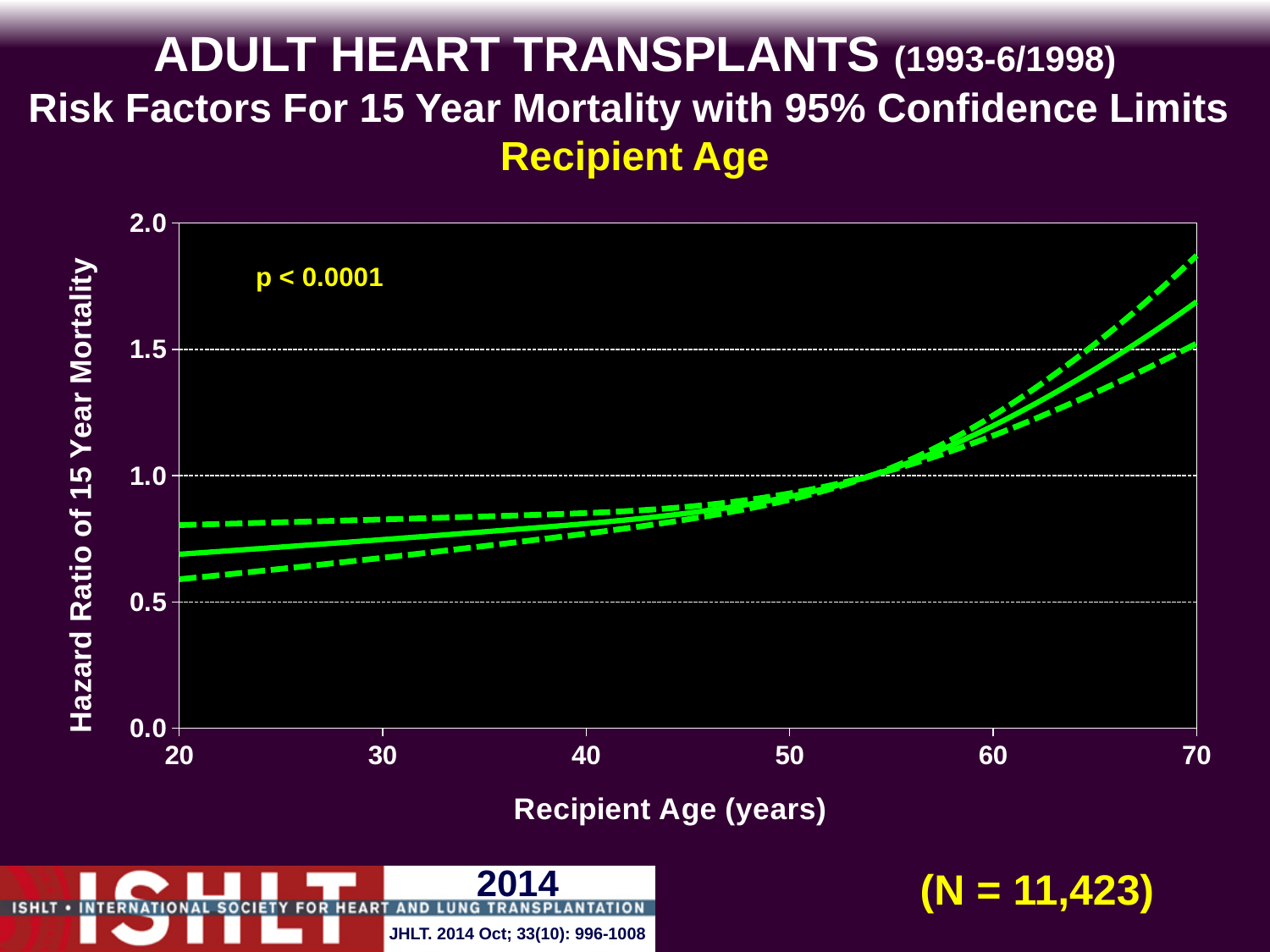
What kind of chart is shown on the slide? line chart Does the hazard ratio of 15 year mortality rise or fall as recipient age increases from 20 to 70 years? rise Which recipient age has the larger hazard ratio, 20 years or 70 years? 70 years Is the hazard ratio for a recipient age of 20 years greater or less than 1.0? less What is the label of the y axis? Hazard Ratio of 15 Year Mortality Is the upper confidence limit at a recipient age of 70 years greater or less than 1.5? greater How many lines are plotted on the chart? 3 Is the hazard ratio for a recipient age of 60 years greater or less than 1.0? greater What p-value is printed on the chart? p < 0.0001